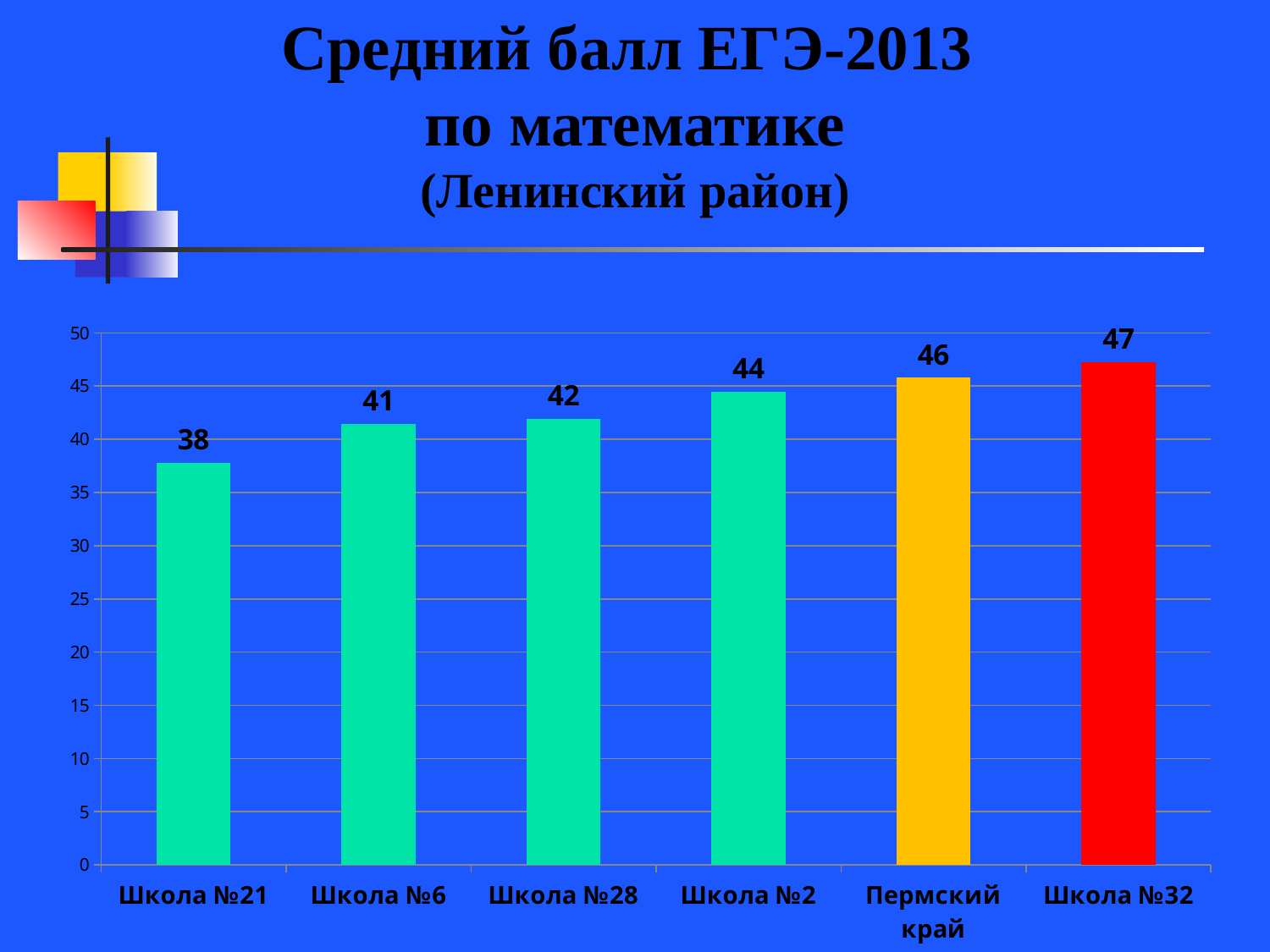
What is the difference between the values for Школа №32 and Школа №21? 9 How many categories are shown on the x axis? 6 Which is larger, the value for Школа №6 or the value for Школа №2? Школа №2 What is the difference between the values for Пермский край and Школа №2? 2 What is the value for Школа №21? 38 What kind of chart is shown on the slide? bar chart Is the value for Школа №21 greater or less than 40? less What is the value for Пермский край? 46 Which category has the highest value? Школа №32 Do the values rise or fall from left to right along the x axis? rise Which category has the lowest value? Школа №21 What is the value for Школа №28? 42